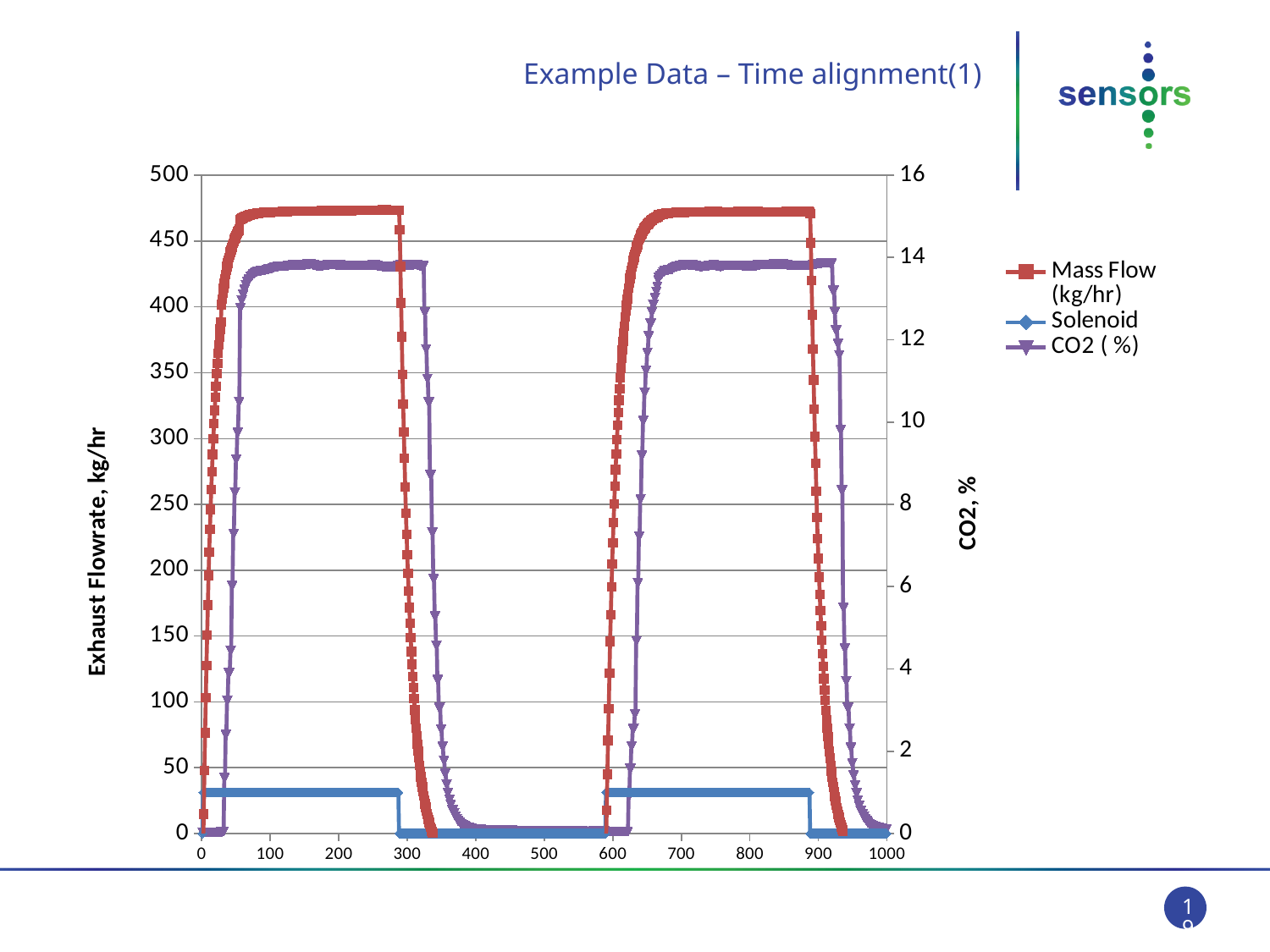
Which is larger, the Mass Flow (kg/hr) value at x = 200 or at x = 500? x = 200 Is the CO2 ( %) value at x = 500 greater or less than 2 on the right axis? less What is the title of the left vertical axis? Exhaust Flowrate, kg/hr What is the highest value shown on the left vertical axis? 500 Is the Mass Flow (kg/hr) value at x = 500 greater or less than 50? less What is the title of the chart slide? Example Data – Time alignment(1) How many series does the legend list? 3 Does the Mass Flow (kg/hr) series rise or fall between x = 300 and x = 350? fall Does the CO2 ( %) series rise or fall between x = 600 and x = 700? rise Is the Mass Flow (kg/hr) value at x = 200 greater or less than 400? greater What kind of chart is shown on the slide? line chart